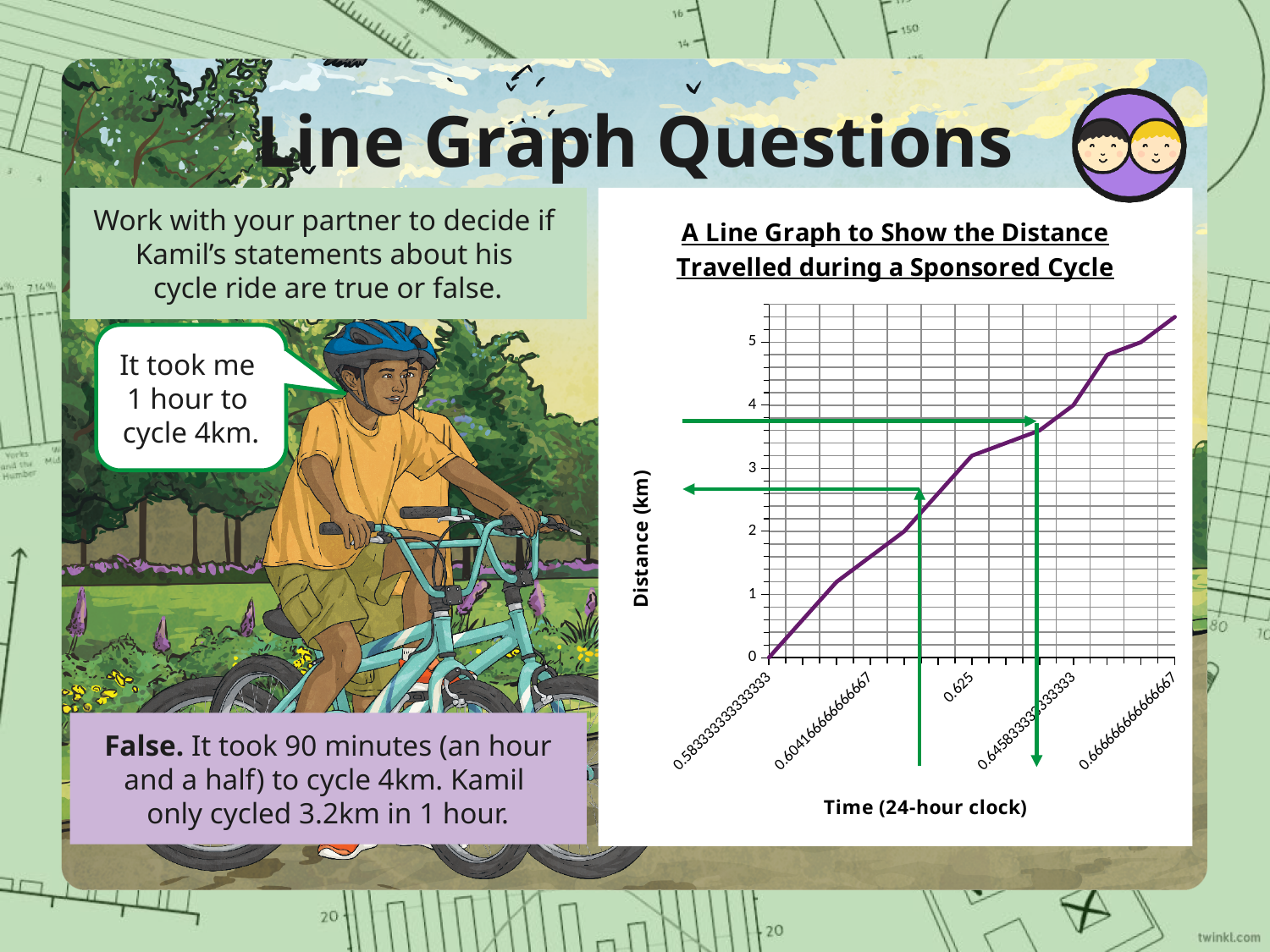
Which is larger, the distance at 0.625 or the distance at 0.604166666666667? 0.625 What is the label on the vertical axis of the chart? Distance (km) What distance is plotted at the first time label, 0.583333333333333? 0 Is the distance at the final point of the line greater or less than 5? greater Is the distance at the time labelled 0.666666666666667 greater or less than 4? greater Is the distance at the time labelled 0.604166666666667 greater or less than 1? greater What is the title of the chart? A Line Graph to Show the Distance Travelled during a Sponsored Cycle What is the highest value marked on the vertical axis? 5 What kind of chart is shown on the slide? line chart Does the distance rise or fall as time increases along the x axis? rise How many time labels are printed along the x axis? 5